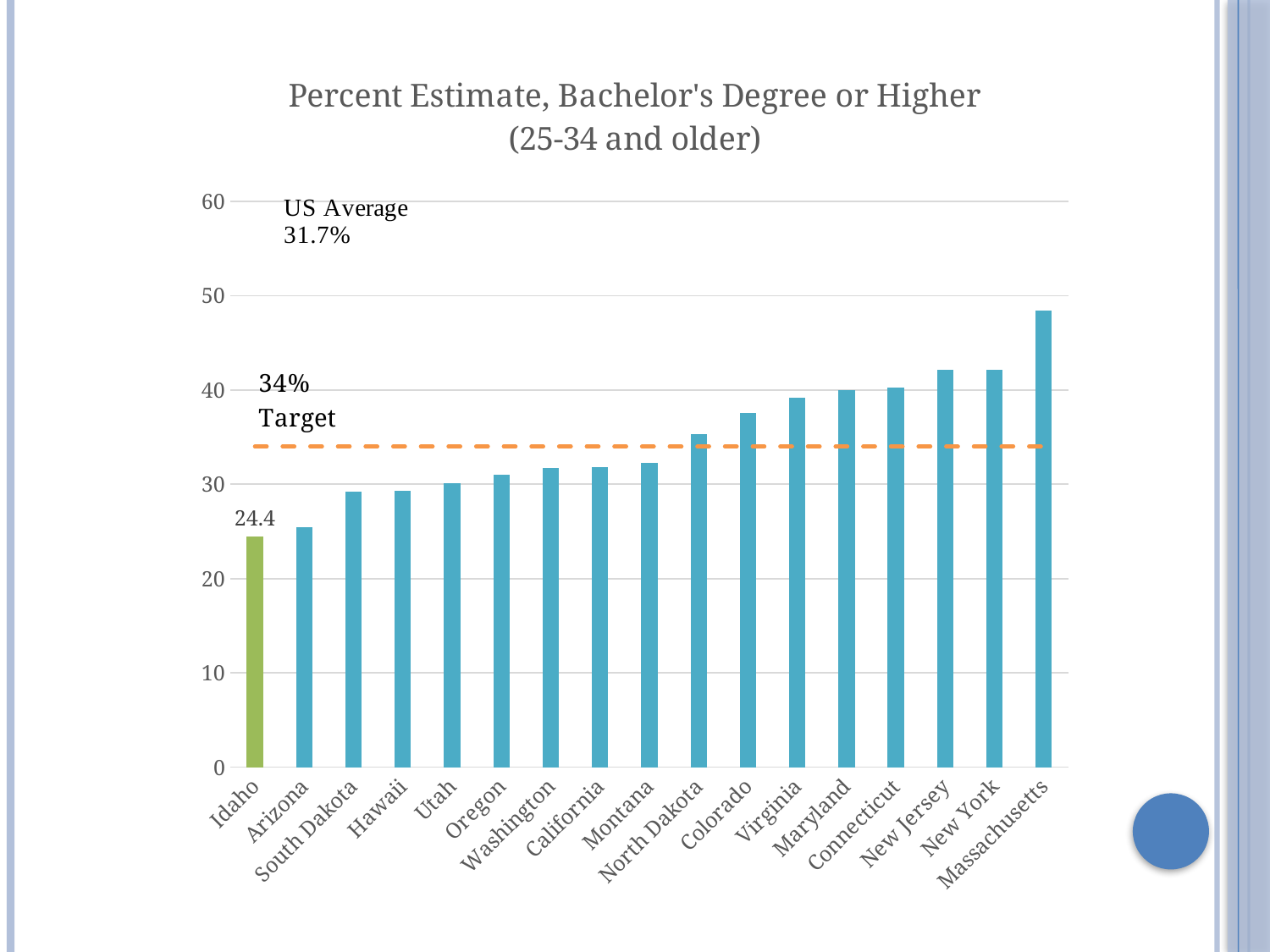
What kind of chart is shown on the slide? Bar chart Do the bar values rise or fall from left to right along the x axis? Rise Is the value for Massachusetts greater or less than 40? greater Which state has the highest bar? Massachusetts What target value does the dashed line on the chart represent? 34% What is the value shown for Idaho? 24.4 Which state has the lowest bar? Idaho Which is larger, the value for Colorado or the value for Arizona? Colorado Is the value for Arizona greater or less than 30? less Is the value for Montana greater or less than 40? less How many states are shown on the x axis? 17 What US Average value is annotated on the chart? 31.7%